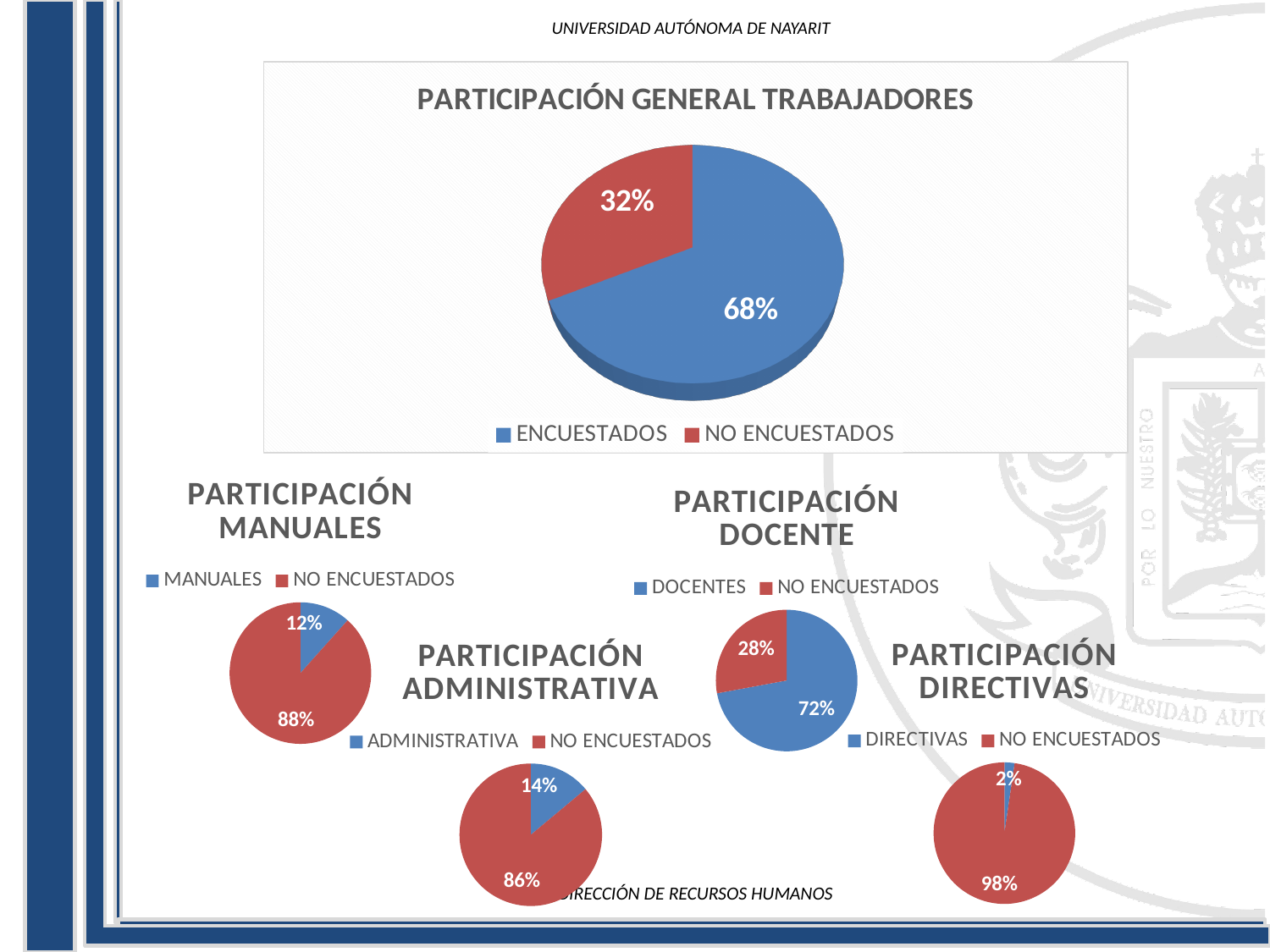
In the PARTICIPACIÓN DOCENTE chart, what share of the pie is DOCENTES? 72% How many series does the legend of the PARTICIPACIÓN DOCENTE chart list? 2 In the PARTICIPACIÓN ADMINISTRATIVA chart, which slice is the smallest? ADMINISTRATIVA In the PARTICIPACIÓN DIRECTIVAS chart, which slice is the largest? NO ENCUESTADOS In the PARTICIPACIÓN GENERAL TRABAJADORES chart, what share of the pie is NO ENCUESTADOS? 32% In the PARTICIPACIÓN ADMINISTRATIVA chart, what share of the pie is NO ENCUESTADOS? 86% In the PARTICIPACIÓN MANUALES chart, which slice is larger, MANUALES or NO ENCUESTADOS? NO ENCUESTADOS What kind of chart is the PARTICIPACIÓN GENERAL TRABAJADORES chart? Pie chart In the PARTICIPACIÓN DOCENTE chart, what is the difference between the DOCENTES and NO ENCUESTADOS shares? 44%